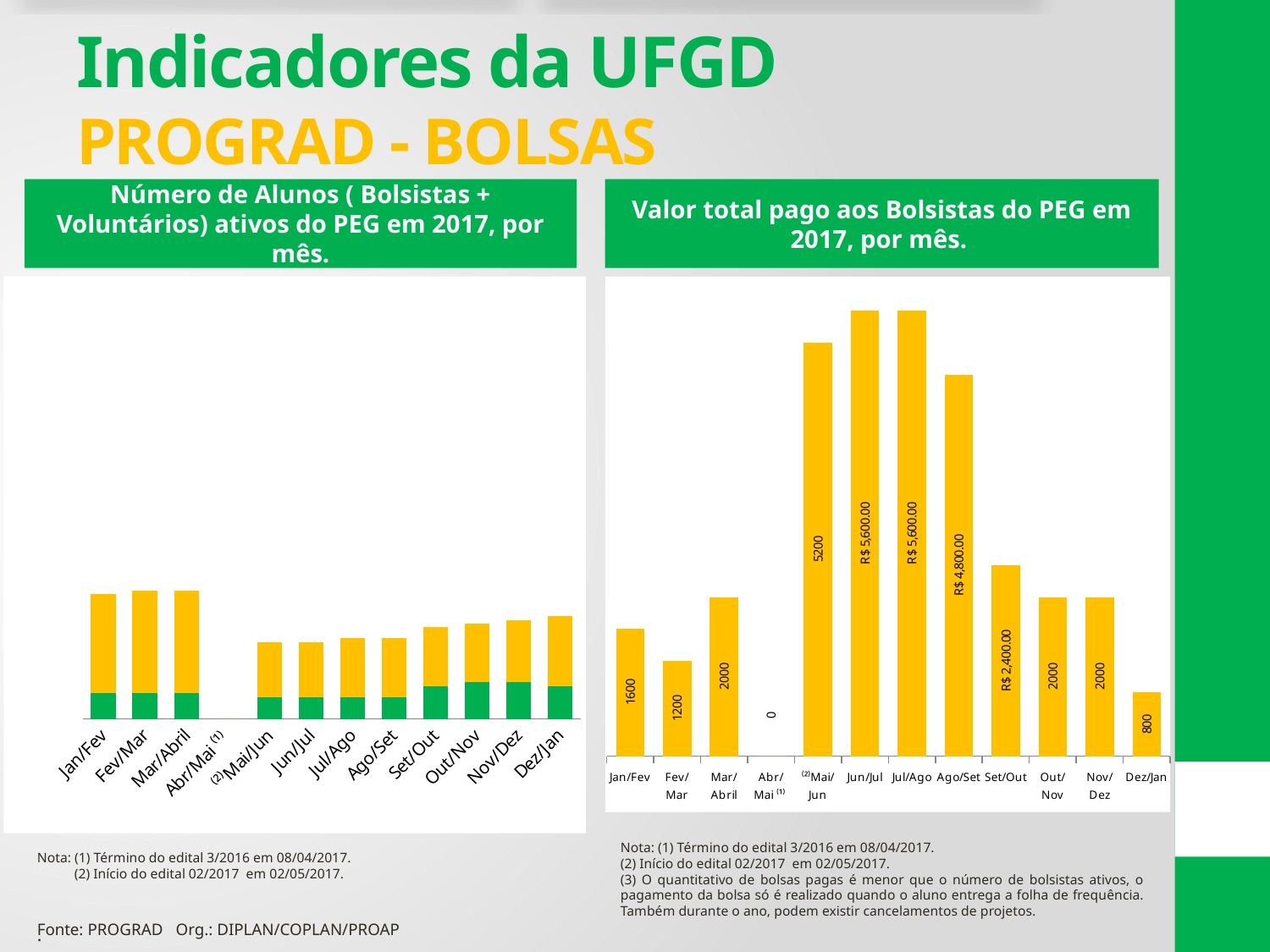
In the chart 'Valor total pago aos Bolsistas do PEG em 2017, por mês', which month pair has the lowest value? Abr/Mai In the chart 'Valor total pago aos Bolsistas do PEG em 2017, por mês', what is the value for Jan/Fev? 1600 In the chart 'Valor total pago aos Bolsistas do PEG em 2017, por mês', what is the value for Ago/Set? R$ 4,800.00 In the chart 'Valor total pago aos Bolsistas do PEG em 2017, por mês', what is the difference between the values for Mai/Jun and Jan/Fev? 3600 In the chart 'Valor total pago aos Bolsistas do PEG em 2017, por mês', which is larger, the value for Set/Out or the value for Dez/Jan? Set/Out In the chart 'Valor total pago aos Bolsistas do PEG em 2017, por mês', what is the value for Jun/Jul? R$ 5,600.00 In the chart 'Valor total pago aos Bolsistas do PEG em 2017, por mês', how many month pairs are shown on the x axis? 12 In the left chart 'Número de Alunos (Bolsistas + Voluntários) ativos do PEG em 2017, por mês', which is larger, the bar for Jan/Fev or the bar for Mai/Jun? Jan/Fev In the chart 'Valor total pago aos Bolsistas do PEG em 2017, por mês', do the values rise or fall from Jul/Ago to Dez/Jan? fall In the chart 'Valor total pago aos Bolsistas do PEG em 2017, por mês', what is the value for Dez/Jan? 800 In the chart 'Valor total pago aos Bolsistas do PEG em 2017, por mês', what is the difference between the values for Jun/Jul and Ago/Set? 800 What kind of chart is the left chart, 'Número de Alunos (Bolsistas + Voluntários) ativos do PEG em 2017, por mês'? stacked bar chart